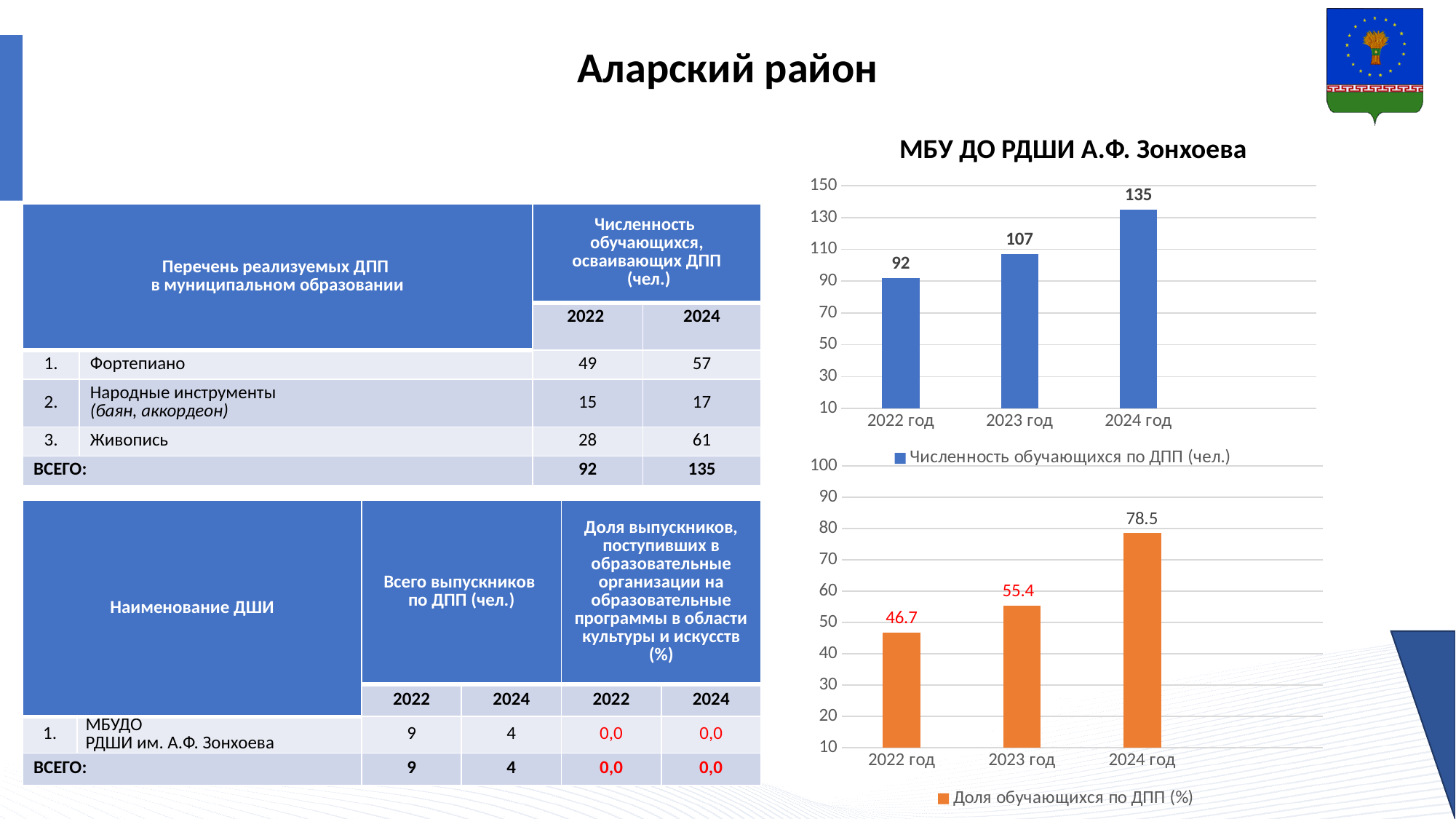
In the top chart (blue bars), what is the difference between the values for 2024 год and 2022 год? 43 In the bottom chart (orange bars), which is larger: the value for 2023 год or the value for 2022 год? 2023 год In the bottom chart (orange bars), what is the value for 2022 год? 46.7 In the top chart (blue bars), which year has the highest value? 2024 год In the bottom chart (orange bars), what is the value for 2024 год? 78.5 In the top chart (blue bars), which year has the lowest value? 2022 год In the top chart (МБУ ДО РДШИ А.Ф. Зонхоева, blue bars), what is the value for 2023 год? 107 In the top chart (blue bars), how many bars are plotted? 3 What type of chart is the bottom chart with orange bars? bar chart In the top chart (blue bars), do the values rise or fall from 2022 год to 2024 год? rise In the bottom chart (orange bars), what is the difference between the values for 2024 год and 2023 год? 23.1 In the top chart (blue bars), what is the value for 2022 год? 92